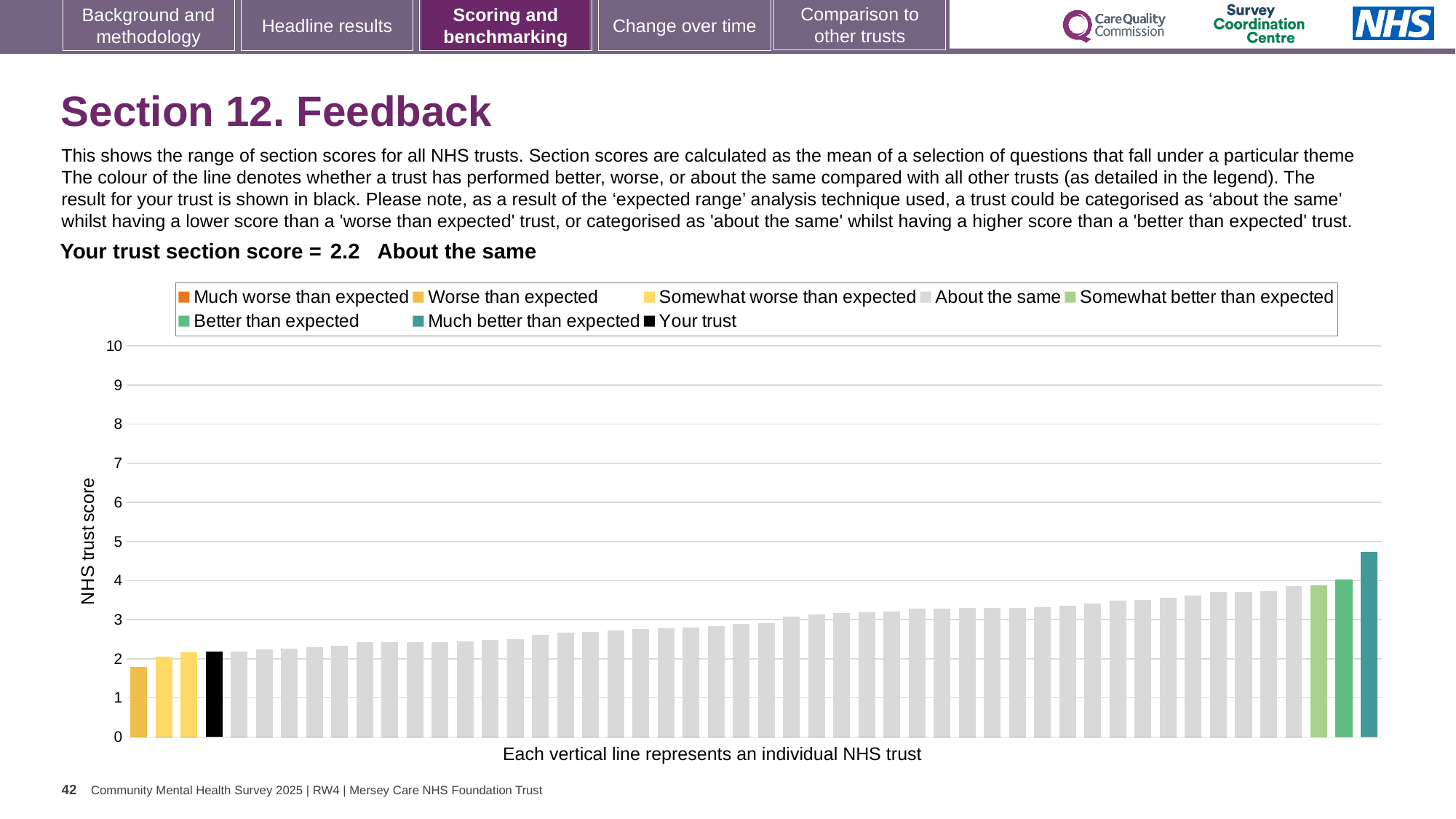
Is the value for your trust (the black bar) greater or less than 3? less How many bars are coloured 'Much better than expected' (teal)? 1 What kind of chart is shown on the slide? bar chart Is the value of the tallest bar (the 'Much better than expected' trust) greater or less than 4? greater Which legend category does the shortest bar on the chart belong to? Worse than expected Do the bar values rise or fall from left to right along the x axis? rise Is the value of the shortest bar on the chart greater or less than 2? less Which legend category does the tallest bar on the chart belong to? Much better than expected How many entries does the chart legend list? 8 What is the label on the vertical axis of the chart? NHS trust score Which category is your trust placed in for this section? About the same What is the section score for your trust shown on the slide? 2.2